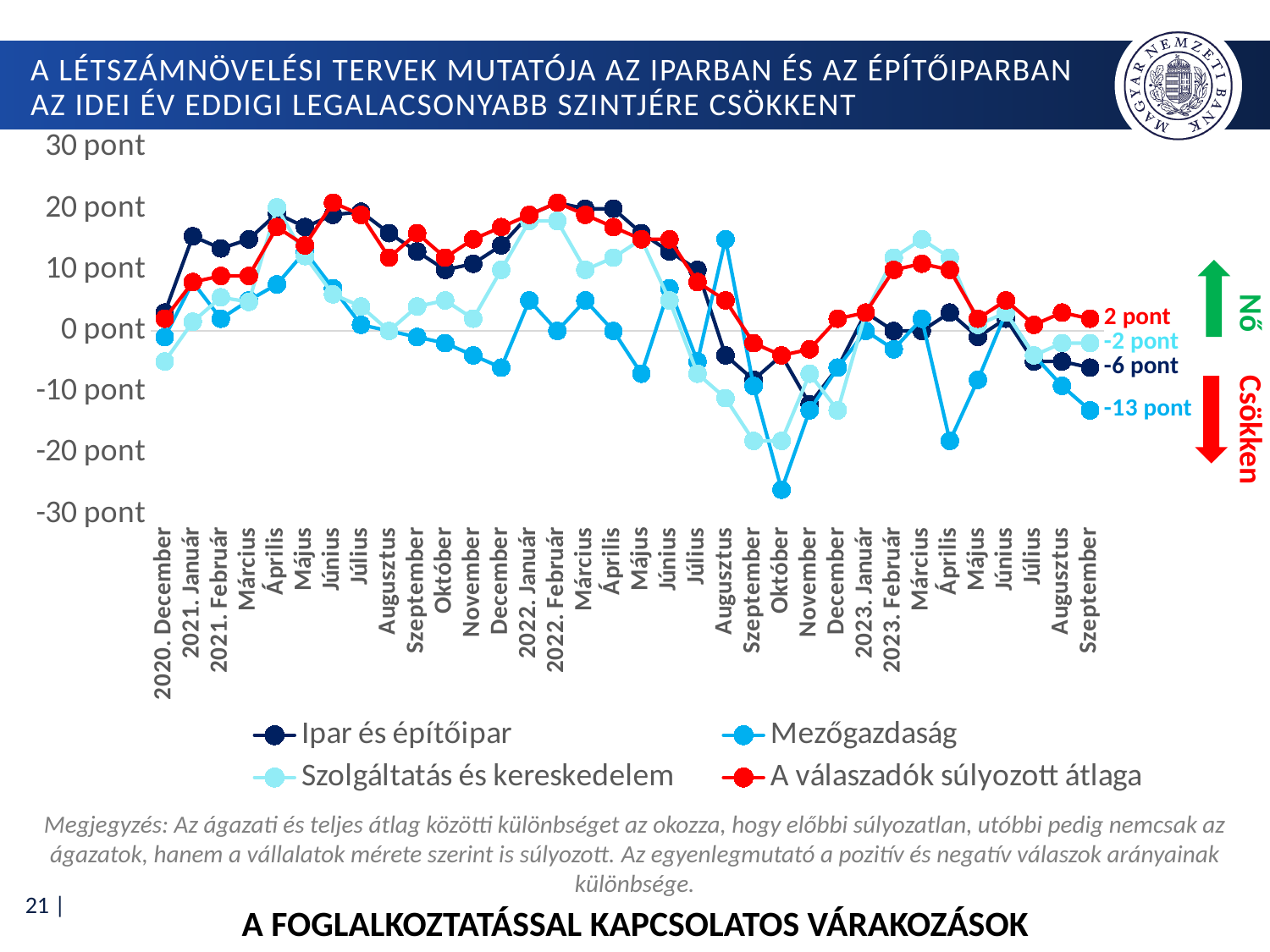
Which series has the highest value in Szeptember 2023? A válaszadók súlyozott átlaga What is the value of 'Szolgáltatás és kereskedelem' in Szeptember 2023? -2 pont Which series has the lowest value in Szeptember 2023? Mezőgazdaság What kind of chart is shown on the slide? line chart How many series does the legend list? 4 What is the value of 'A válaszadók súlyozott átlaga' in Szeptember 2023? 2 pont What is the value of 'Mezőgazdaság' in Szeptember 2023? -13 pont Does the 'Mezőgazdaság' series rise or fall from Június 2023 to Szeptember 2023? fall Which series is drawn in red? A válaszadók súlyozott átlaga Is the value for 'Mezőgazdaság' in Október 2022 greater or less than -20 pont? less What is the difference between 'A válaszadók súlyozott átlaga' and 'Mezőgazdaság' in Szeptember 2023? 15 pont What is the value of 'Ipar és építőipar' in Szeptember 2023? -6 pont